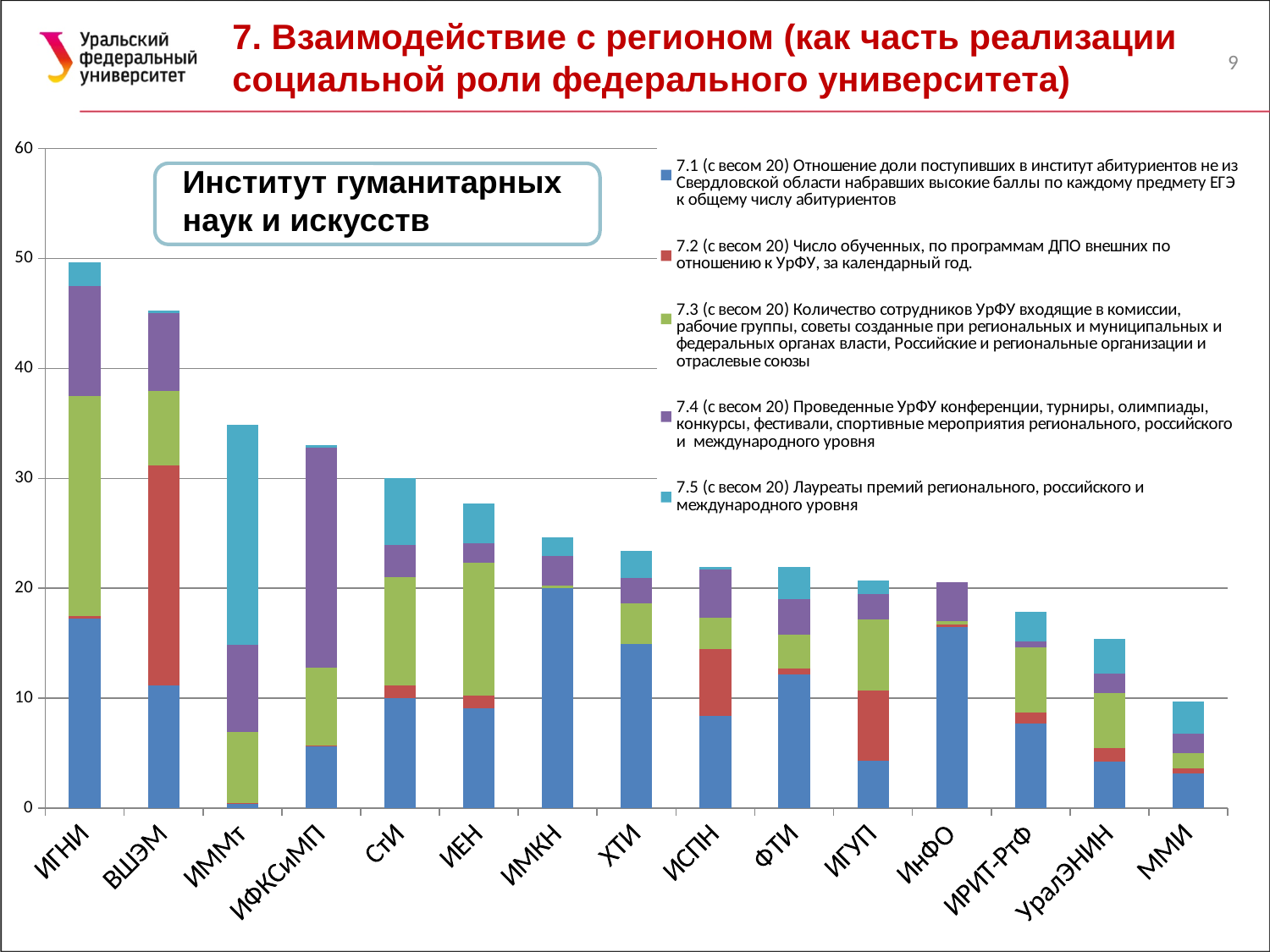
Which institute has the highest total bar in the chart? ИГНИ What text is shown in the callout box placed over the chart? Институт гуманитарных наук и искусств How many series does the chart's legend list? 5 Is the total bar for ИРИТ-РтФ greater or less than 20? less Which institute has the lowest total bar in the chart? ММИ How many institutes (categories) are shown along the x axis of the chart? 15 Is the total bar for ИММт greater or less than 40? less Which has the taller total bar, СтИ or ИЕН? СтИ What kind of chart is shown on the slide? Stacked bar chart Which has the taller total bar, ИГНИ or ВШЭМ? ИГНИ Do the total bar heights rise or fall moving from left to right along the x axis? Fall Is the total bar for ИГНИ greater or less than 40? greater